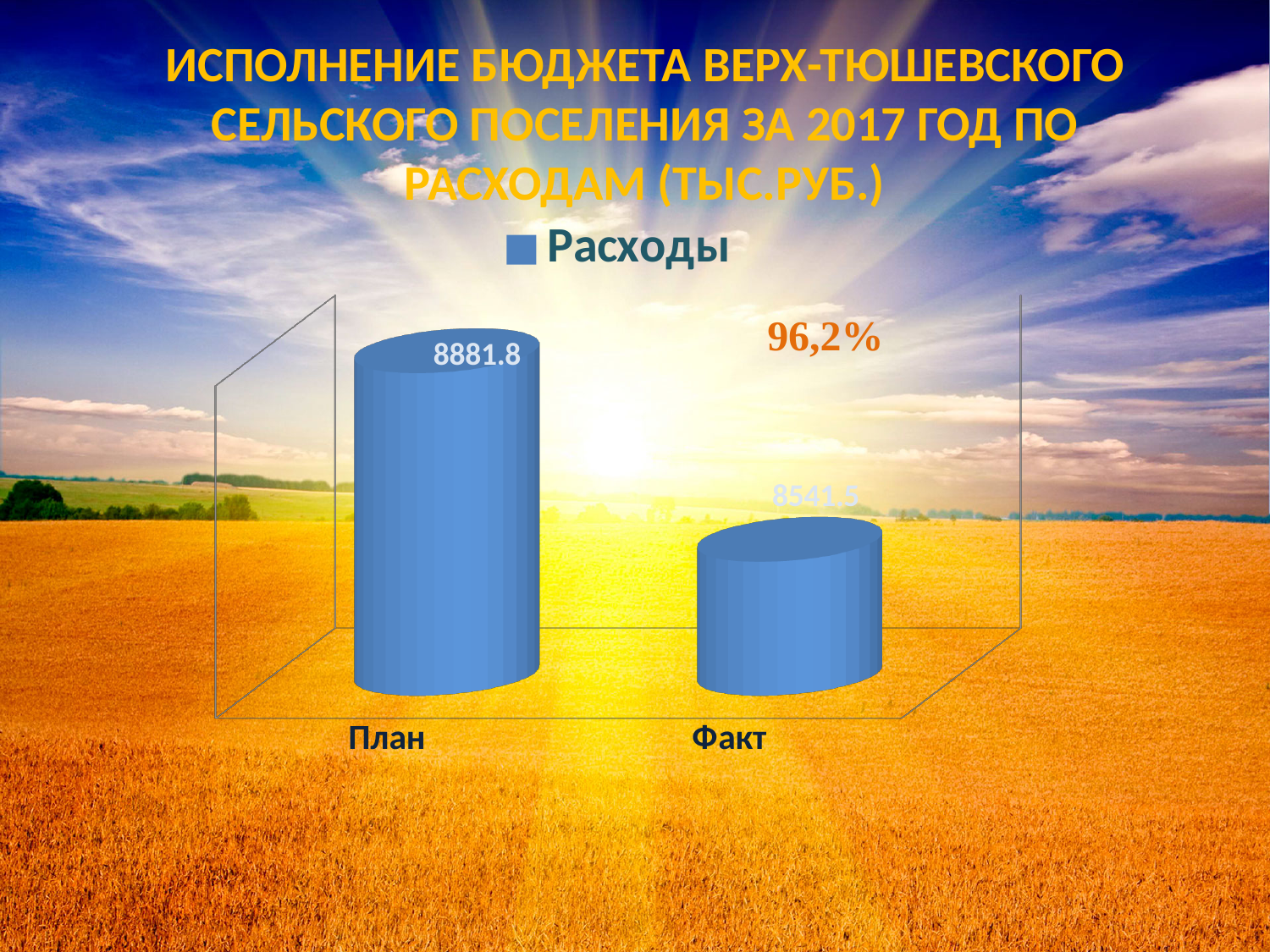
What is the difference between the values for План and Факт? 340.3 What is the name of the series shown in the legend? Расходы What percentage is printed next to the chart? 96,2% How many categories are shown on the chart? 2 Which is larger, the value for План or the value for Факт? План What is the value for План? 8881.8 Which category has the lowest value? Факт What is the value for Факт? 8541.5 What kind of chart is shown on the slide? bar chart How many series does the legend list? 1 Which category has the highest value? План